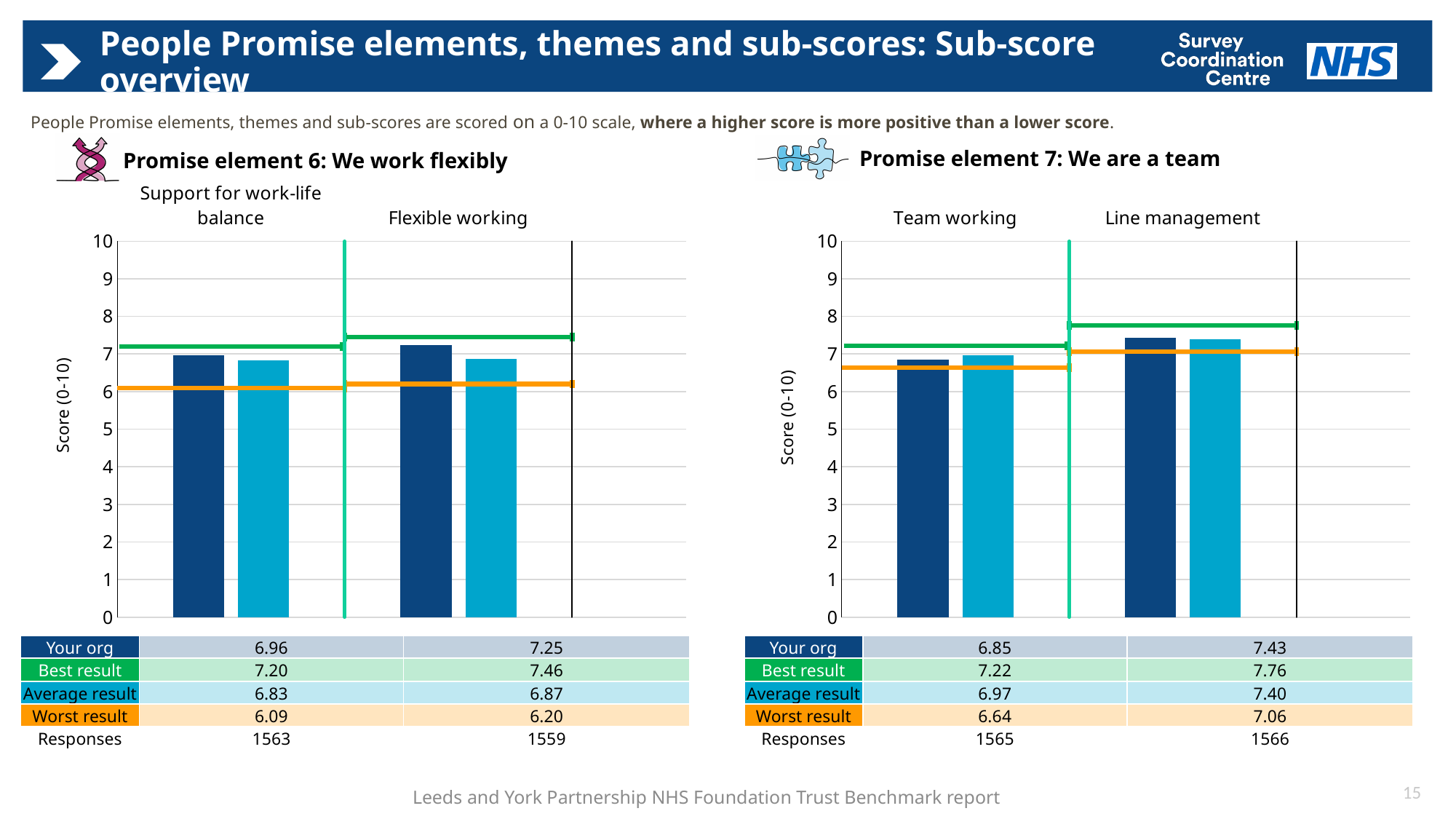
In the 'Promise element 7: We are a team' chart, is the 'Your org' value for Line management greater or less than 7? greater In the 'Promise element 6: We work flexibly' chart, what is the Best result for Flexible working? 7.46 In the 'Promise element 6: We work flexibly' chart, what is the difference between the 'Your org' score and the Average result for Flexible working? 0.38 In the 'Promise element 7: We are a team' chart, which is larger for Team working: the 'Your org' score or the Average result? Average result In the 'Promise element 6: We work flexibly' chart, which sub-score has the higher 'Your org' value? Flexible working In the 'Promise element 7: We are a team' chart, how many responses are recorded for Line management? 1566 In the 'Promise element 7: We are a team' chart, what is the 'Your org' score for Line management? 7.43 How many sub-score categories are shown in the 'Promise element 6: We work flexibly' chart? 2 In the 'Promise element 7: We are a team' chart, what is the difference between the Best result and the Worst result for Line management? 0.70 In the 'Promise element 7: We are a team' chart, what is the Worst result for Team working? 6.64 What kind of chart is used for 'Promise element 7: We are a team'? Bar chart In the 'Promise element 6: We work flexibly' chart, what is the 'Your org' score for Support for work-life balance? 6.96